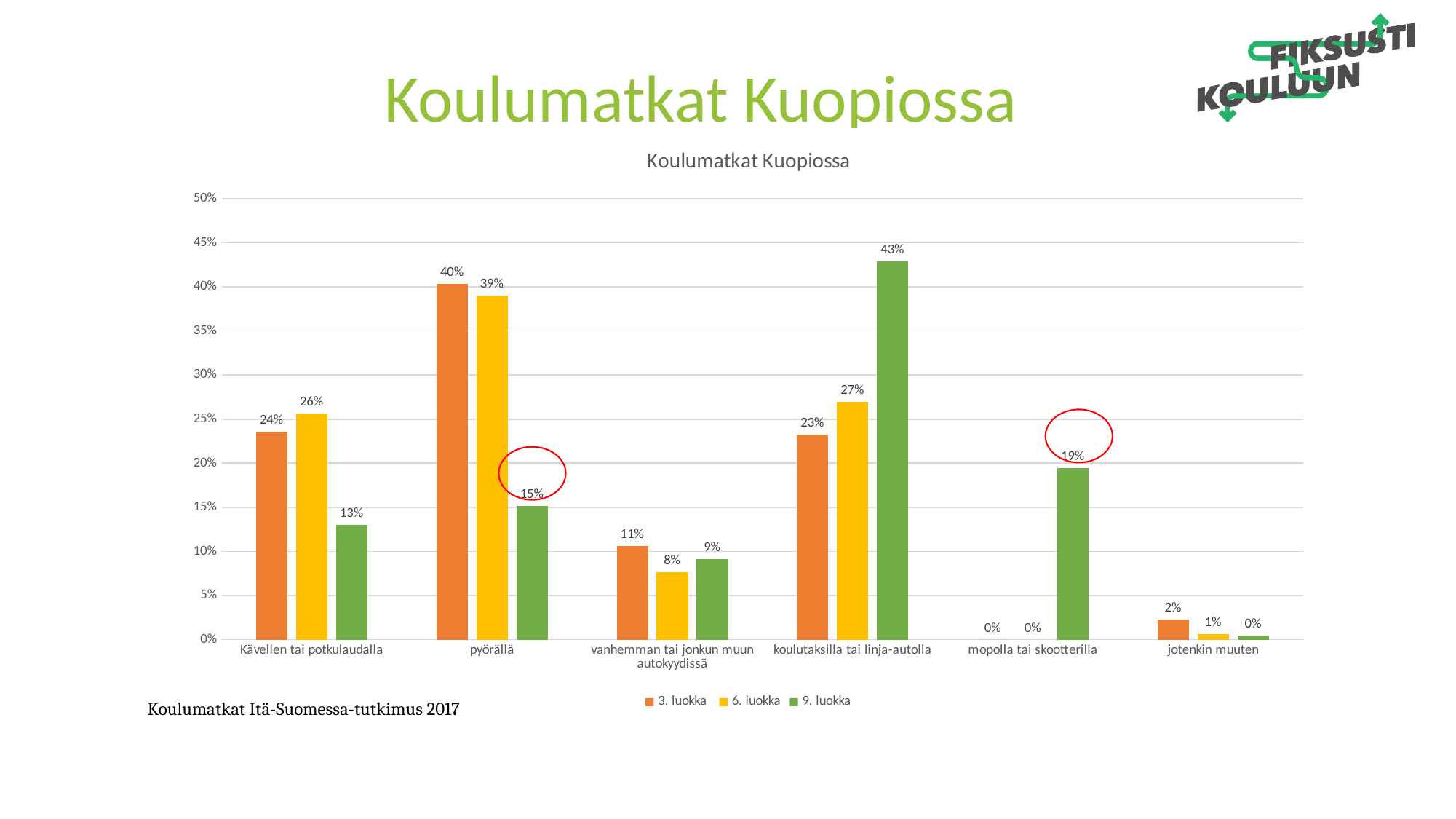
What is the value for 6. luokka in the Kävellen tai potkulaudalla category? 26% How many series does the legend list? 3 Which category has the lowest value for 3. luokka? mopolla tai skootterilla How many categories are shown on the x axis? 6 What kind of chart is shown on the slide? bar chart Which is larger in the vanhemman tai jonkun muun autokyydissä category: 3. luokka or 6. luokka? 3. luokka What is the value for 9. luokka in the mopolla tai skootterilla category? 19% Which category has the highest value for 9. luokka? koulutaksilla tai linja-autolla What is the value for 9. luokka in the koulutaksilla tai linja-autolla category? 43% What is the difference between the 3. luokka and 9. luokka values in the pyörällä category? 25% What is the value for 3. luokka in the pyörällä category? 40% What is the title of the chart? Koulumatkat Kuopiossa